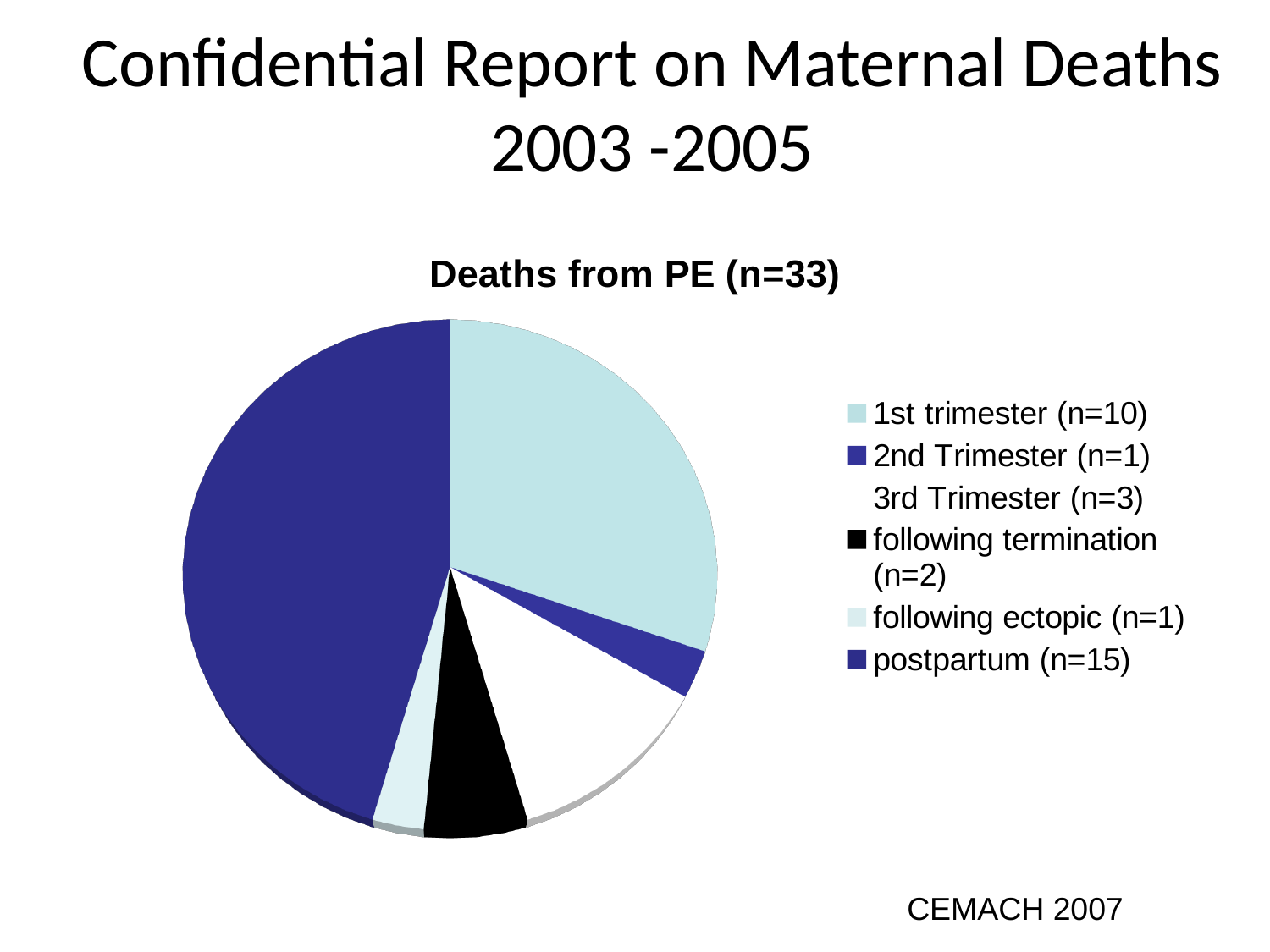
How many deaths are attributed to postpartum? 15 What is the difference between the 3rd Trimester deaths and the following termination deaths? 1 How many categories does the pie chart's legend list? 6 What type of chart is shown on the slide? Pie chart Which is larger, the number of deaths in the 2nd Trimester or the 3rd Trimester? 3rd Trimester How many deaths are attributed to the 1st trimester? 10 Which category has the largest number of deaths? postpartum (n=15) What is the title of the chart? Deaths from PE (n=33) What is the difference between the postpartum deaths and the 1st trimester deaths? 5 How many deaths are attributed to following termination? 2 How many deaths are attributed to the 3rd Trimester? 3 Which is larger, the number of deaths in the 1st trimester or postpartum? postpartum